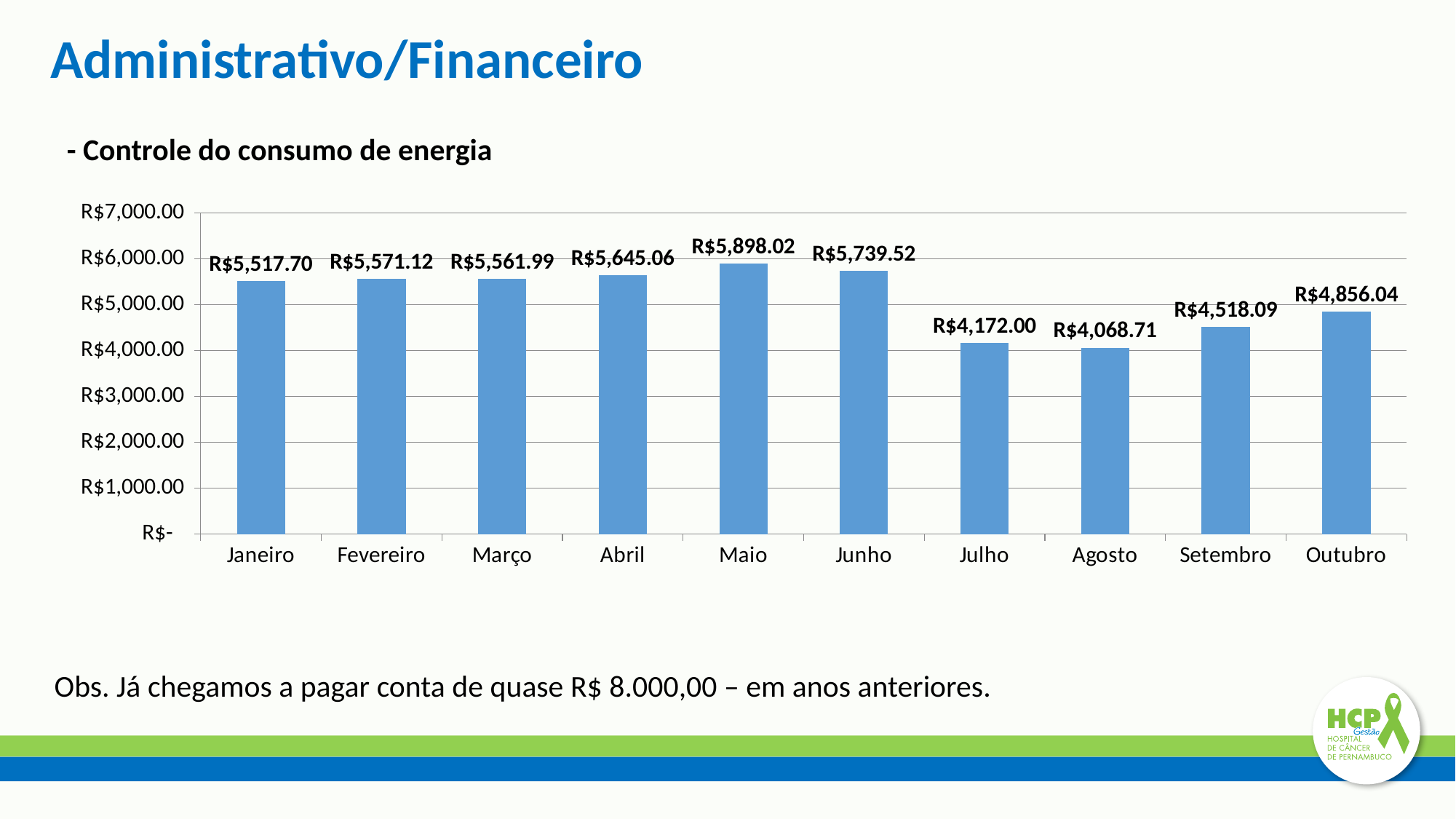
How many months are shown on the x axis? 10 What is the difference between the values for Maio and Agosto? R$1,829.31 Do the values rise or fall from Agosto to Outubro? rise Is the value for Julho greater or less than R$4,000.00? greater What kind of chart is shown on the slide? bar chart What is the value for Agosto? R$4,068.71 Which month has the highest value? Maio Which month has the lowest value? Agosto What is the value for Maio? R$5,898.02 What is the value for Outubro? R$4,856.04 Which is larger, the value for Junho or the value for Julho? Junho What is the difference between the values for Outubro and Setembro? R$337.95